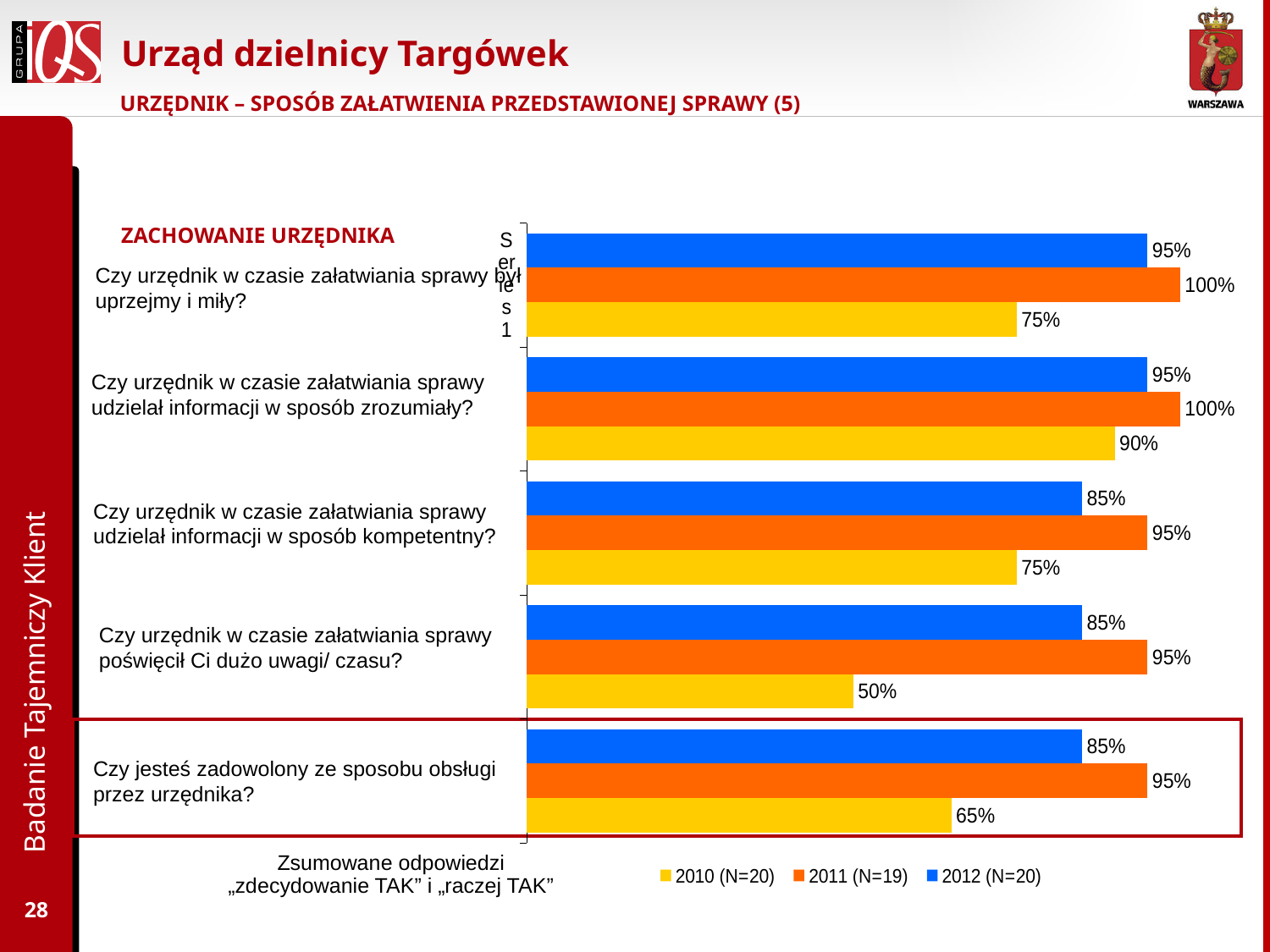
What is the 2010 (N=20) value for "Czy urzędnik w czasie załatwiania sprawy poświęcił Ci dużo uwagi/ czasu?"? 50% What is the 2011 (N=19) value for "Czy urzędnik w czasie załatwiania sprawy był uprzejmy i miły?"? 100% What kind of chart is shown on the slide? bar chart How many series does the legend list? 3 For "Czy urzędnik w czasie załatwiania sprawy udzielał informacji w sposób kompetentny?", which is larger: the 2011 value or the 2012 value? 2011 What is the difference between the 2012 and 2010 values for "Czy urzędnik w czasie załatwiania sprawy był uprzejmy i miły?"? 20 percentage points Which question has the lowest 2010 (N=20) value? Czy urzędnik w czasie załatwiania sprawy poświęcił Ci dużo uwagi/ czasu? What is the difference between the 2011 and 2010 values for "Czy jesteś zadowolony ze sposobu obsługi przez urzędnika?"? 30 percentage points What is the 2010 (N=20) value for "Czy urzędnik w czasie załatwiania sprawy udzielał informacji w sposób zrozumiały?"? 90% Which colour represents the 2011 (N=19) series in the chart? orange What is the 2012 (N=20) value for "Czy jesteś zadowolony ze sposobu obsługi przez urzędnika?"? 85% How many questions (categories) are plotted in the chart? 5